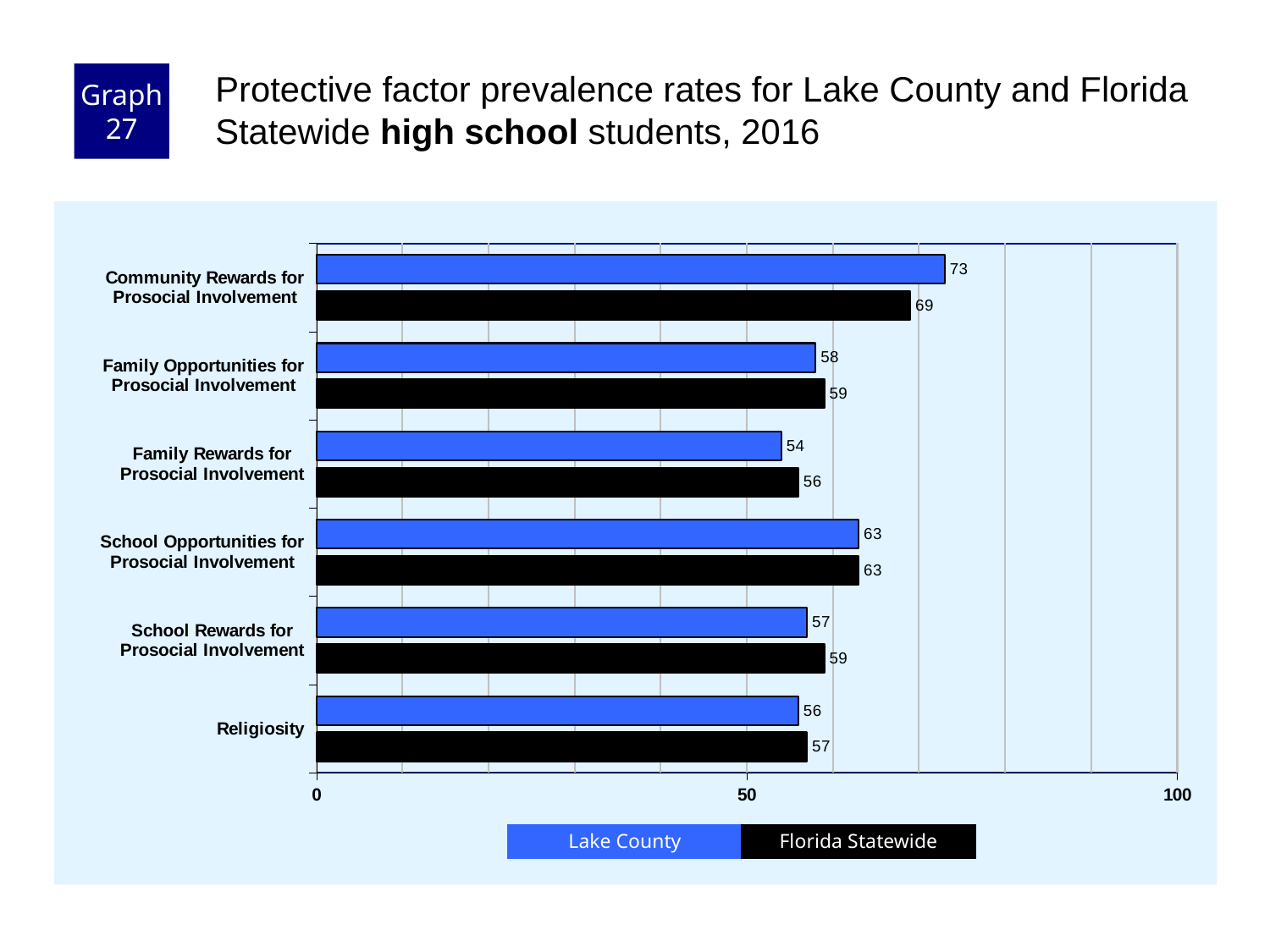
What is the Lake County value for Community Rewards for Prosocial Involvement? 73 What kind of chart is shown on the slide? bar chart For School Rewards for Prosocial Involvement, which is larger: the Lake County value or the Florida Statewide value? Florida Statewide Which series is shown in black? Florida Statewide Is the Lake County value for School Opportunities for Prosocial Involvement greater or less than 50? greater What is the Lake County value for Religiosity? 56 What is the difference between the Lake County and Florida Statewide values for Community Rewards for Prosocial Involvement? 4 Which category has the lowest Florida Statewide value? Family Rewards for Prosocial Involvement How many categories are shown on the chart? 6 How many series does the legend list? 2 What is the Florida Statewide value for Family Rewards for Prosocial Involvement? 56 Which category has the highest Lake County value? Community Rewards for Prosocial Involvement